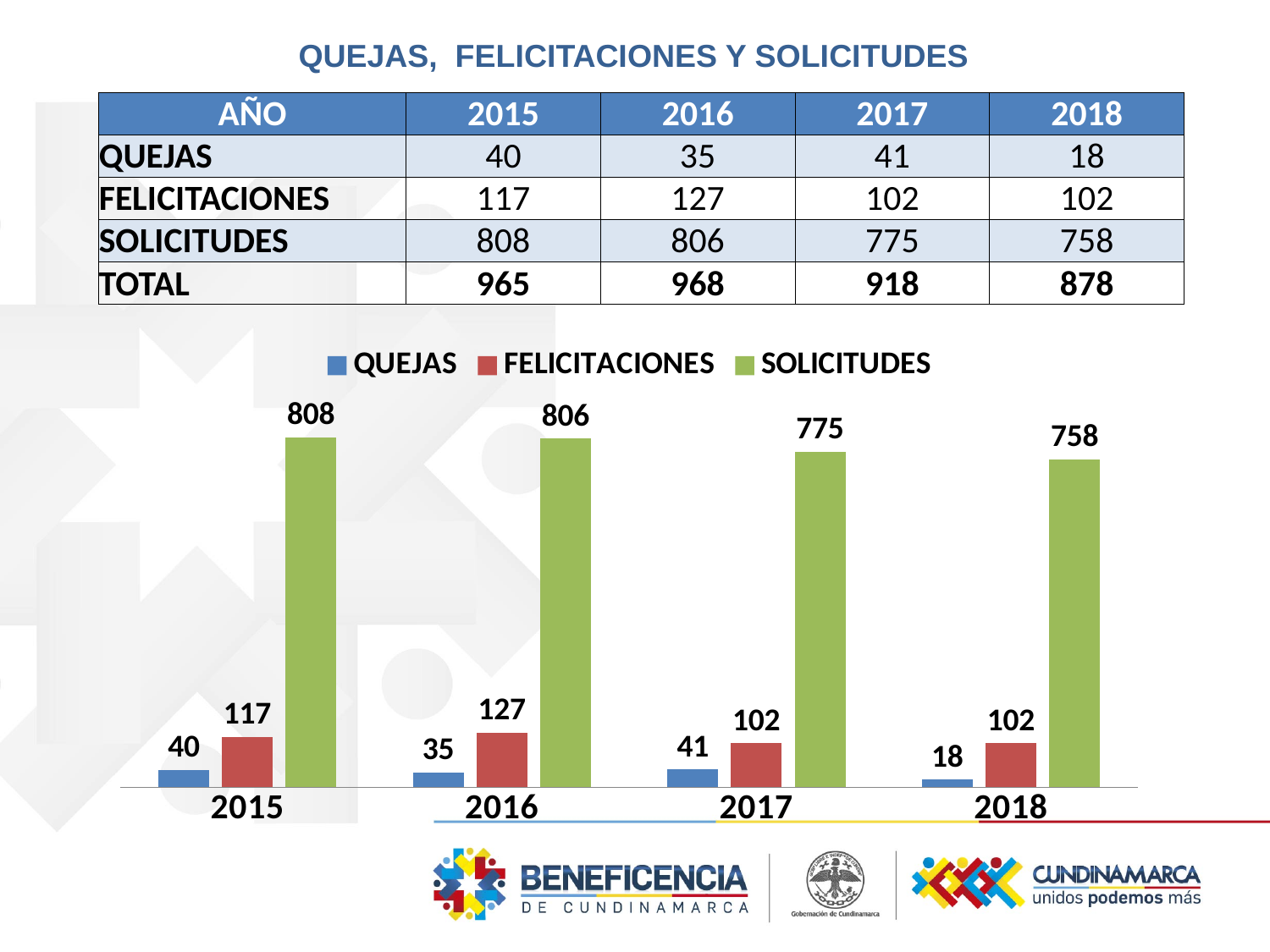
What is the difference between SOLICITUDES in 2015 and SOLICITUDES in 2018? 50 Which year has the lowest value for QUEJAS? 2018 Which is larger, QUEJAS in 2015 or QUEJAS in 2016? QUEJAS in 2015 What kind of chart is shown on the slide? Bar chart What is the value of SOLICITUDES for 2015? 808 Do the SOLICITUDES values rise or fall from 2015 to 2018? Fall How many series does the legend list? 3 What is the value of QUEJAS for 2018? 18 How many years are shown on the x axis of the chart? 4 Which year has the highest value for FELICITACIONES? 2016 What colour are the SOLICITUDES bars in the chart? Green What is the value of FELICITACIONES for 2016? 127